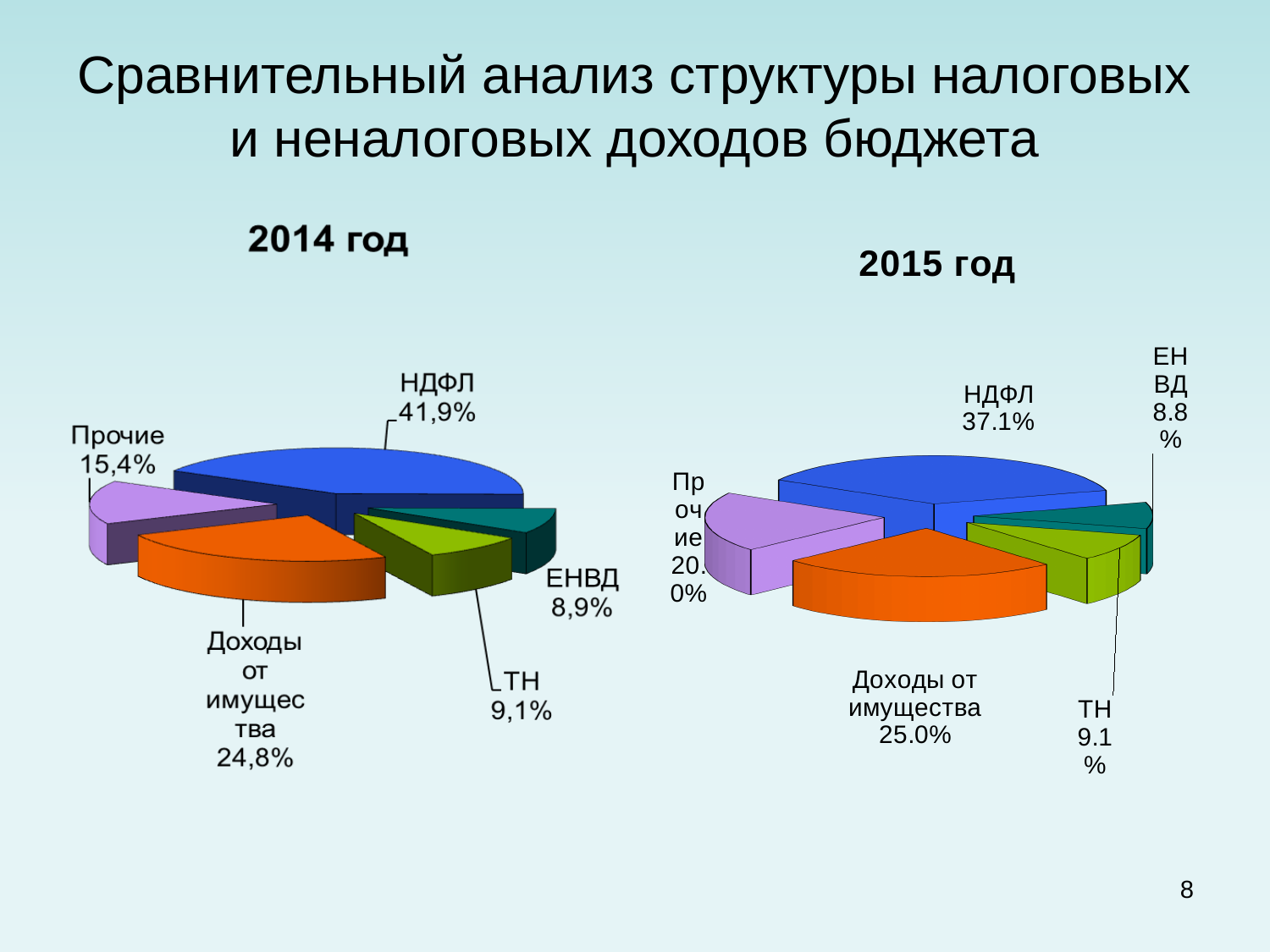
Is the share of НДФЛ larger in the 2014 год chart or the 2015 год chart? 2014 год In the 2014 год chart, what share does НДФЛ have? 41,9% How many slices does the 2015 год pie chart have? 5 In the 2014 год chart, what is the value for Доходы от имущества? 24,8% In the 2014 год chart, which category has the largest share? НДФЛ What type of chart is used for the 2014 год data? pie chart In the 2014 год chart, what is the difference in percentage points between НДФЛ and Доходы от имущества? 17,1 In the 2015 год chart, what is the value for ЕНВД? 8.8% In the 2015 год chart, what share does Прочие have? 20.0% In the 2014 год chart, which category has the smallest share? ЕНВД In the 2015 год chart, which is larger: Прочие or ТН? Прочие In the 2015 год chart, which category has the largest share? НДФЛ